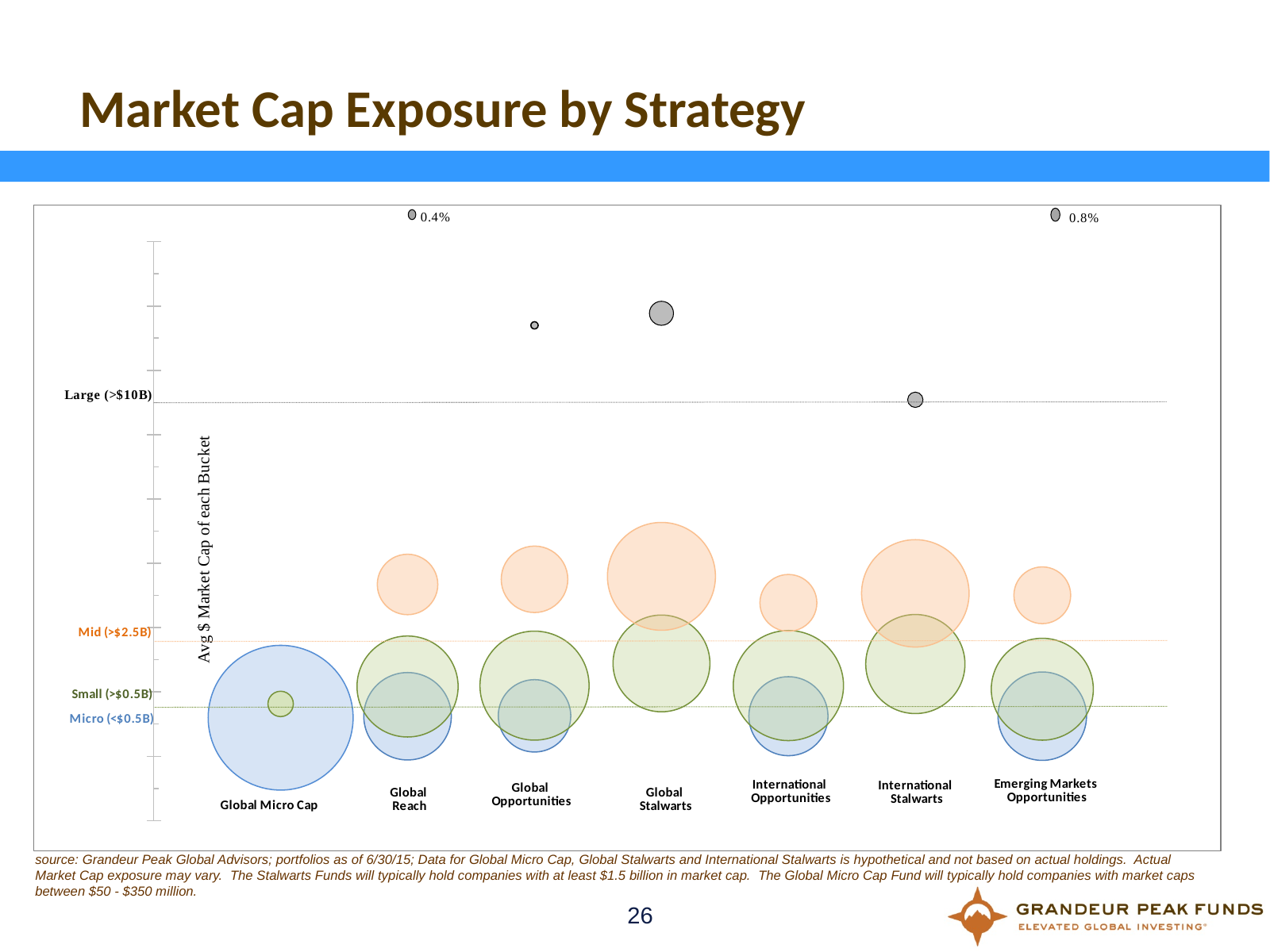
What kind of chart is shown on the slide? Bubble chart Which strategy has the smallest green (Small) bubble? Global Micro Cap Which two strategies have no blue (Micro) bubble? Global Stalwarts and International Stalwarts Which strategy has the largest blue (Micro) bubble? Global Micro Cap What market cap threshold is given for the Large bucket on the vertical axis? >$10B What market cap threshold is given for the Mid bucket on the vertical axis? >$2.5B What is the title of the chart? Market Cap Exposure by Strategy How many market cap buckets are labelled on the vertical axis? 4 How many strategies are shown along the horizontal axis of the chart? 7 Which strategy has the largest gray (Large) bubble? Global Stalwarts Which strategy has no orange (Mid) bubble? Global Micro Cap